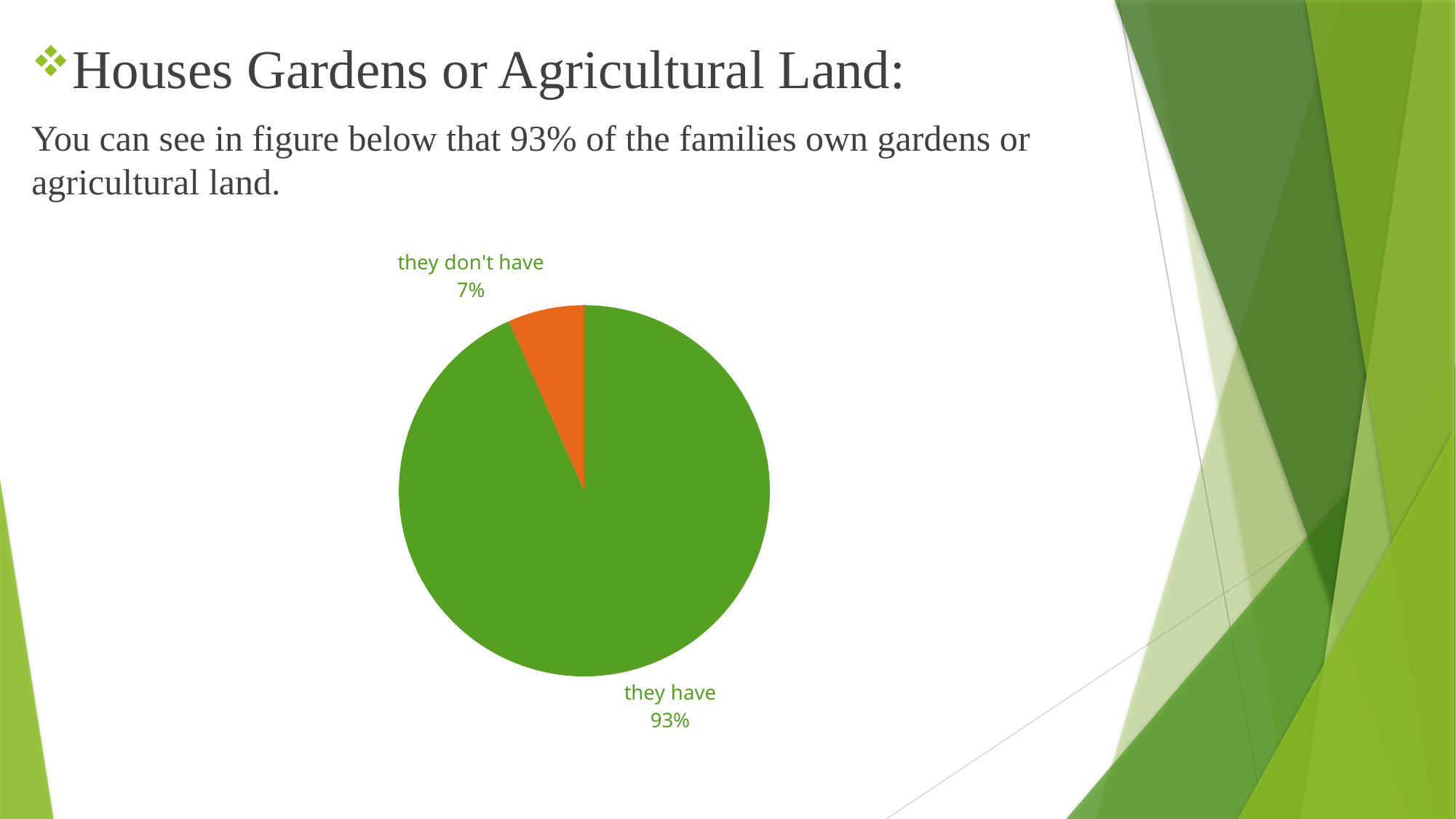
What kind of chart is shown on the slide? pie chart What colour is the 'they have' slice? green Which is larger, the 'they have' slice or the 'they don't have' slice? they have What percentage of families are in the 'they don't have' slice? 7% What percentage of families are in the 'they have' slice? 93% What colour is the 'they don't have' slice? orange How many slices does the pie chart have? 2 What share of the pie does the 'they don't have' slice represent? 7% What is the difference in percentage points between the 'they have' and 'they don't have' slices? 86 Which slice of the pie chart is the largest? they have Which slice of the pie chart is the smallest? they don't have